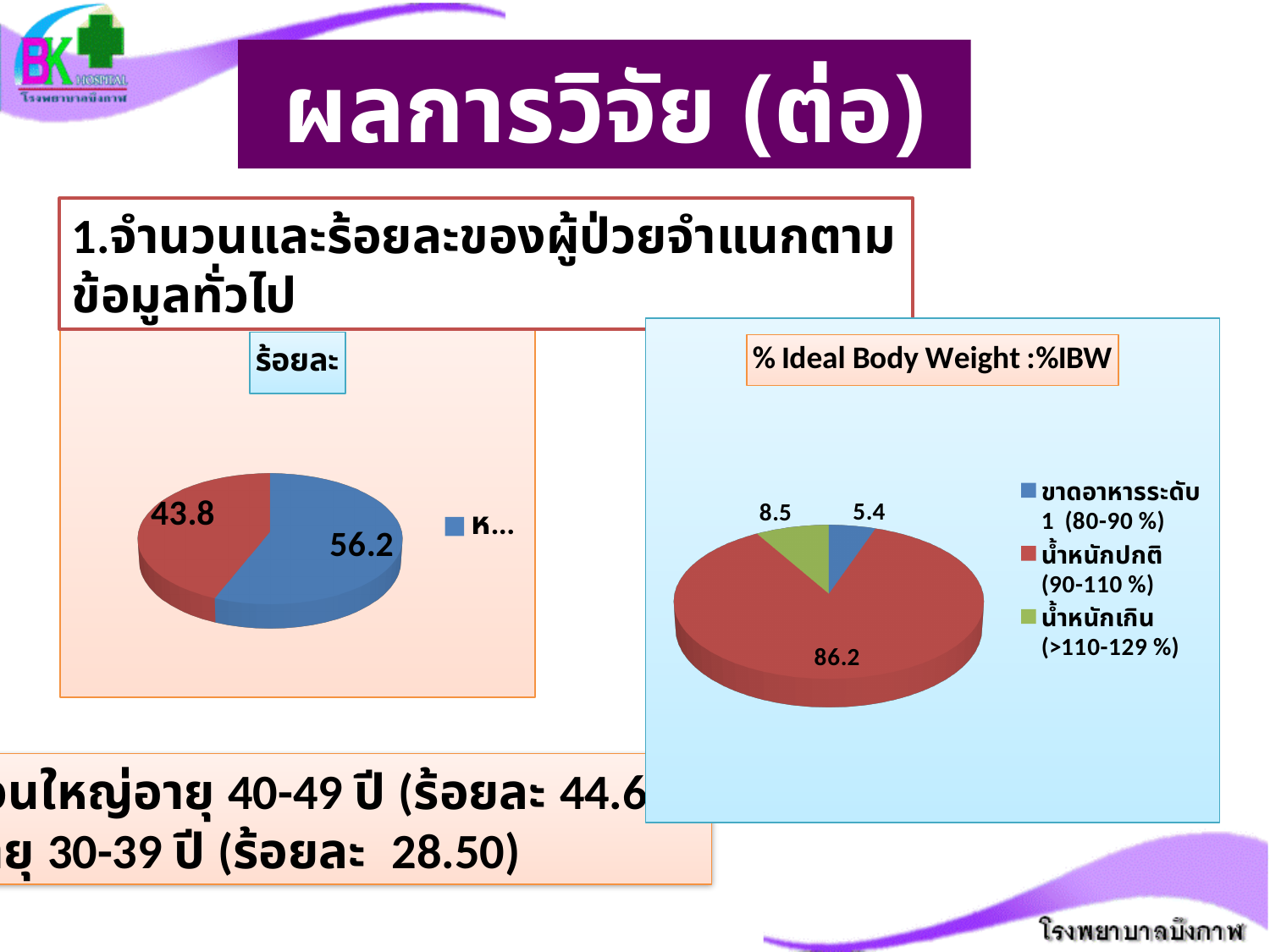
In the chart titled "% Ideal Body Weight :%IBW", what is the value for ขาดอาหารระดับ 1 (80-90 %)? 5.4 In the chart titled "ร้อยละ" on the left of the slide, what is the value of the blue slice? 56.2 In the chart titled "% Ideal Body Weight :%IBW", how many categories does the legend list? 3 In the chart titled "% Ideal Body Weight :%IBW", what is the difference between the values for น้ำหนักเกิน (>110-129 %) and ขาดอาหารระดับ 1 (80-90 %)? 3.1 In the chart titled "ร้อยละ" on the left of the slide, what is the difference between the two slice values? 12.4 In the chart titled "% Ideal Body Weight :%IBW", what colour is the slice for น้ำหนักปกติ (90-110 %)? red In the chart titled "% Ideal Body Weight :%IBW", which category has the largest slice? น้ำหนักปกติ (90-110 %) What kind of chart is the chart titled "% Ideal Body Weight :%IBW"? pie chart In the chart titled "% Ideal Body Weight :%IBW", what is the value for น้ำหนักปกติ (90-110 %)? 86.2 In the chart titled "% Ideal Body Weight :%IBW", what is the value for น้ำหนักเกิน (>110-129 %)? 8.5 In the chart titled "% Ideal Body Weight :%IBW", which category has the smallest slice? ขาดอาหารระดับ 1 (80-90 %) In the chart titled "% Ideal Body Weight :%IBW", which is larger, น้ำหนักเกิน (>110-129 %) or ขาดอาหารระดับ 1 (80-90 %)? น้ำหนักเกิน (>110-129 %)